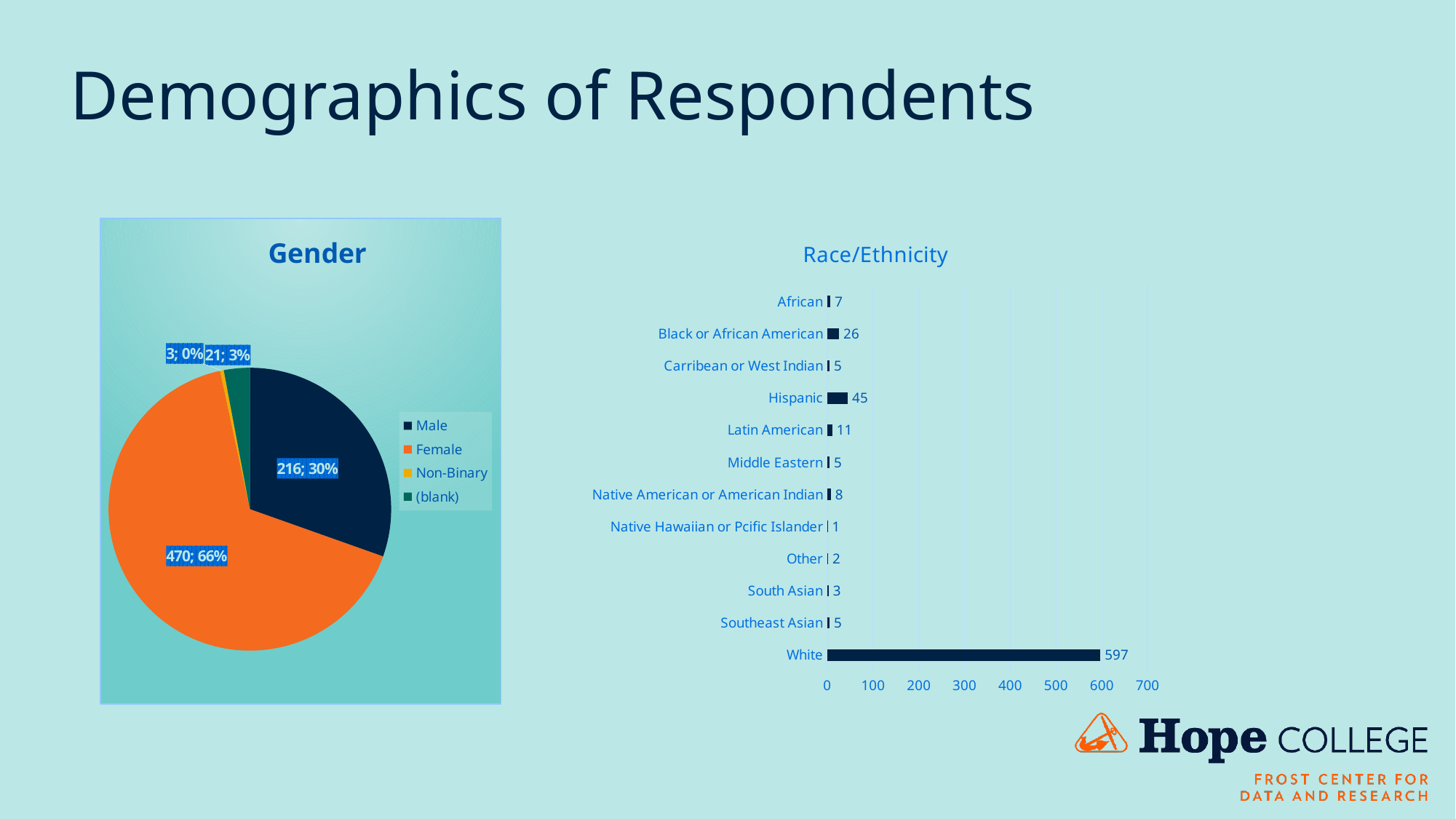
In the Race/Ethnicity chart, which category has the lowest value? Native Hawaiian or Pcific Islander In the Gender pie chart, which category has the smallest slice? Non-Binary In the Race/Ethnicity chart, which is larger: Black or African American or Latin American? Black or African American In the Race/Ethnicity chart, how many categories are shown? 12 In the Race/Ethnicity chart, which category has the highest value? White What kind of chart is the Race/Ethnicity chart? Bar chart In the Race/Ethnicity chart, what is the value for Hispanic? 45 In the Gender pie chart, what share of the pie does Male represent? 30% In the Race/Ethnicity chart, what is the difference between White and Hispanic? 552 In the Gender pie chart, how many entries does the legend list? 4 In the Gender pie chart, what is the value for Female? 470; 66% In the Gender pie chart, what is the difference between the Female and Male counts? 254